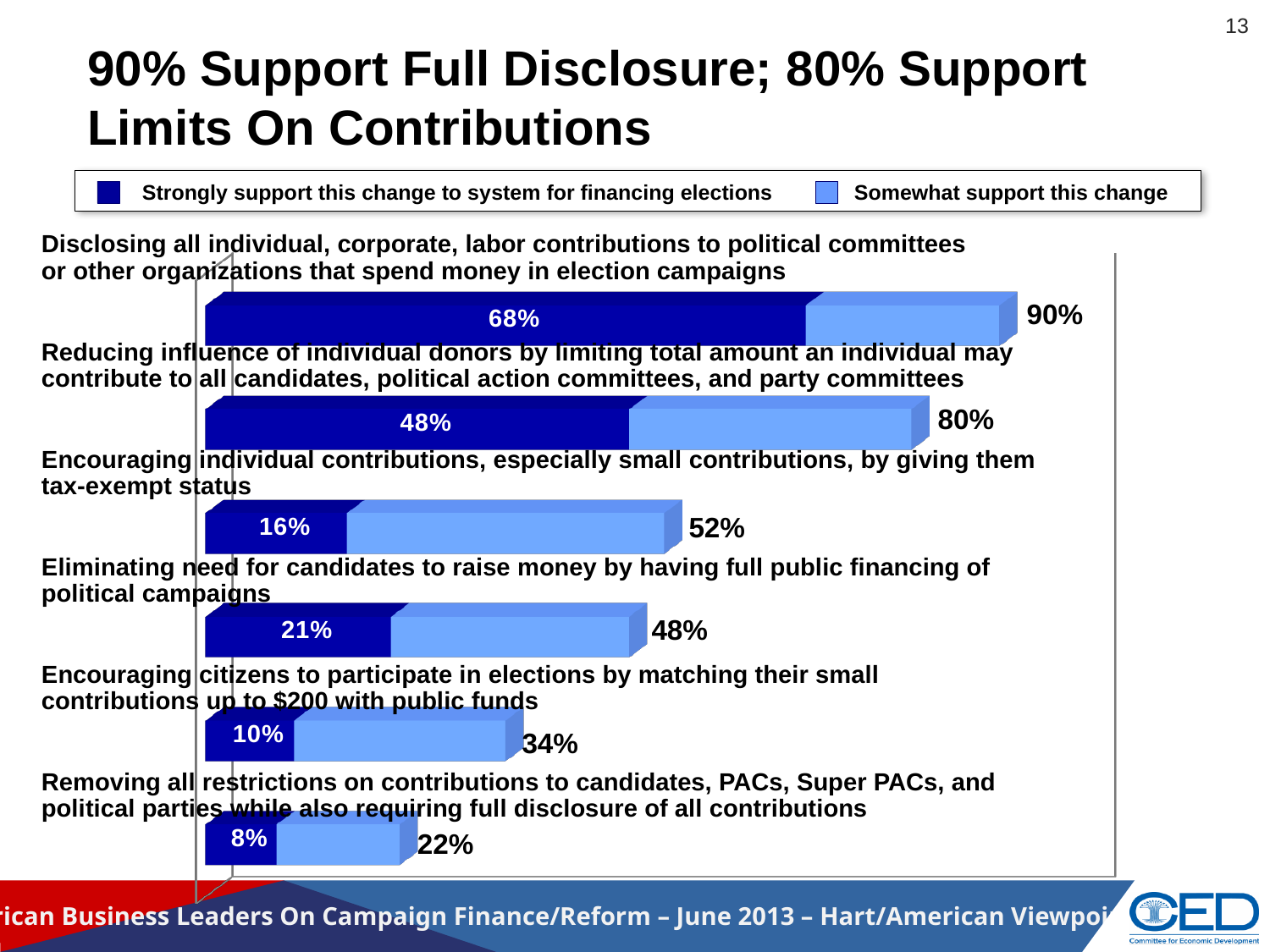
Which proposal has the highest share of respondents who strongly support it? Disclosing all individual, corporate, labor contributions to political committees or other organizations that spend money in election campaigns Which proposal has the lowest total support? Removing all restrictions on contributions to candidates, PACs, Super PACs, and political parties while also requiring full disclosure of all contributions What does the dark blue segment of each bar represent according to the legend? Strongly support this change to system for financing elections What kind of chart is shown on the slide? Stacked bar chart Which has a larger strongly-support share: full public financing of political campaigns or matching small contributions up to $200 with public funds? Full public financing of political campaigns What is the total support shown for eliminating the need for candidates to raise money by having full public financing of political campaigns? 48% How many proposals are shown in the chart? 6 What is the difference between the total support and the strongly support share for disclosing all contributions to political committees? 22% What is the total support (strongly plus somewhat) for reducing influence of individual donors by limiting the total amount an individual may contribute? 80% What percentage strongly support encouraging individual contributions by giving them tax-exempt status? 16% What percentage strongly support disclosing all individual, corporate, labor contributions to political committees or other organizations that spend money in election campaigns? 68% How many series does the legend list? 2